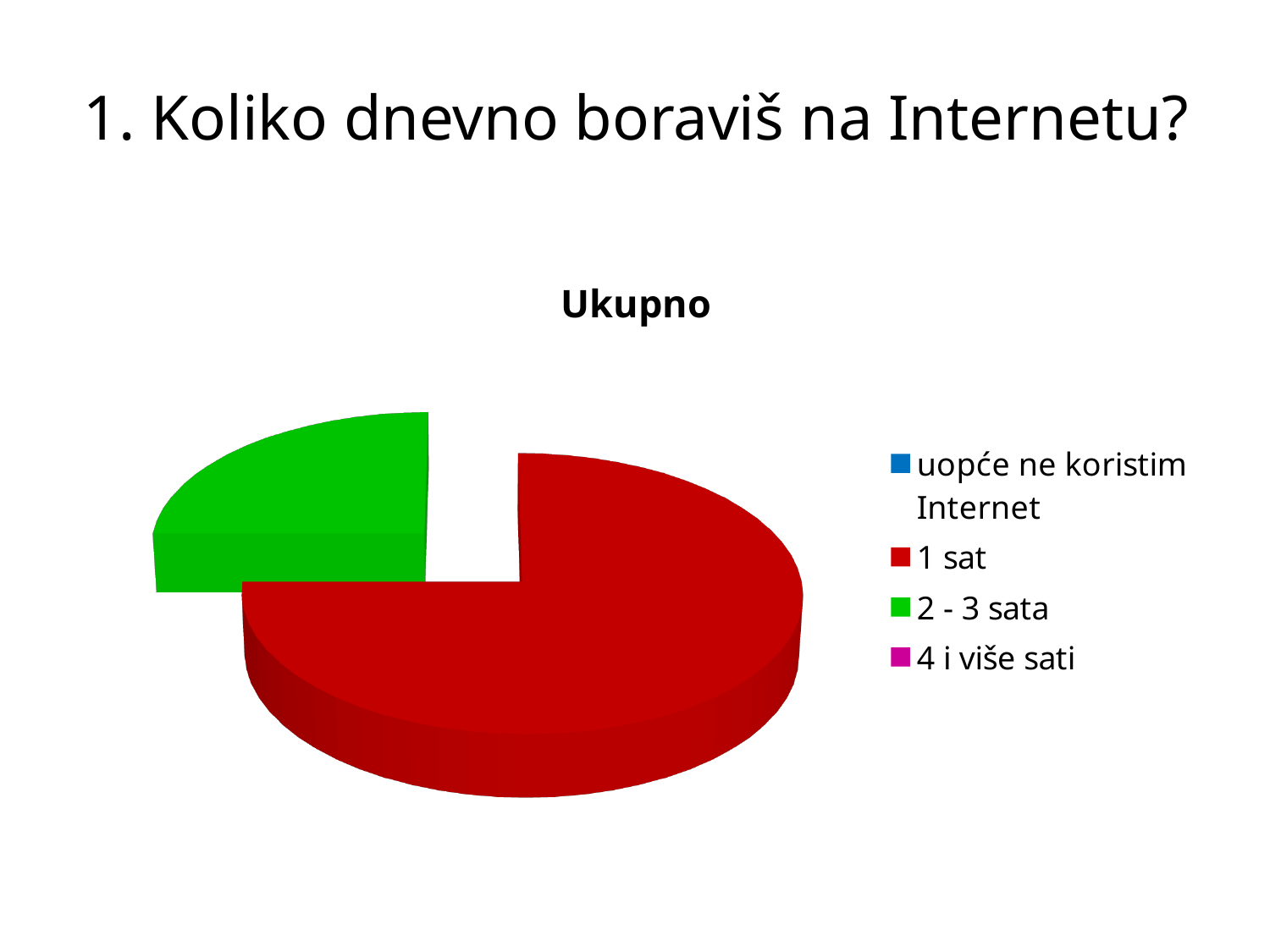
How many slices are visibly drawn in the pie? 2 Is the share of the "1 sat" slice greater or less than 50%? greater What is the title of the chart? Ukupno Which slice is larger, "1 sat" or "2 - 3 sata"? 1 sat What colour is the slice for "2 - 3 sata"? green Is the share of the "2 - 3 sata" slice greater or less than 50%? less What kind of chart is shown on the slide? pie chart How many entries does the chart legend list? 4 Which category has the largest slice of the pie? 1 sat Which legend entry corresponds to the red slice? 1 sat